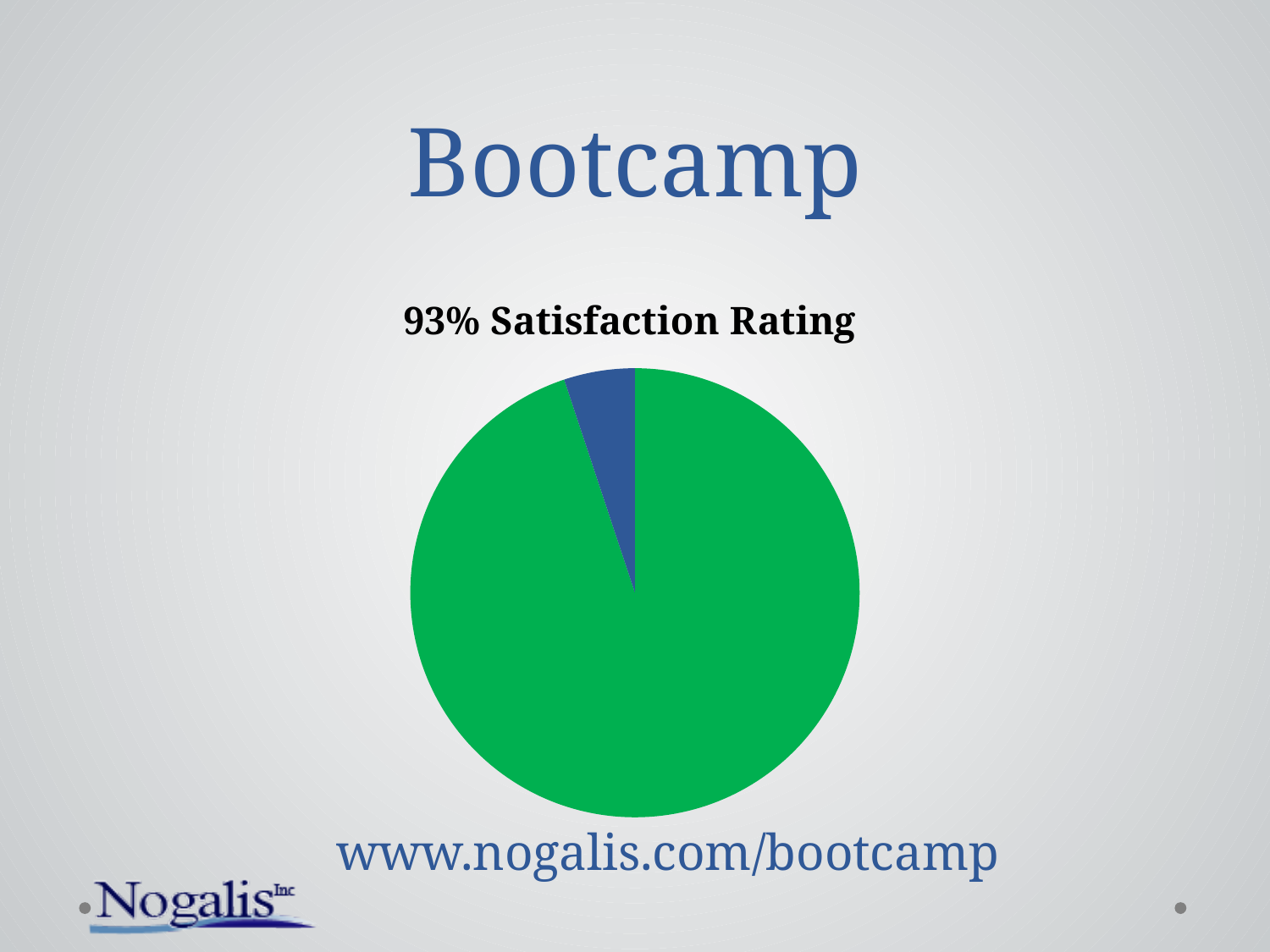
What colour is the largest slice of the pie chart? green What kind of chart is shown on the slide? pie chart Is the share of the blue slice greater or less than 50%? less What share of the pie does the green slice represent, according to the chart title? 93% Is the share of the green slice greater or less than 50%? greater Which slice is larger, the green slice or the blue slice? green What is the title of the chart? 93% Satisfaction Rating How many slices does the pie chart have? 2